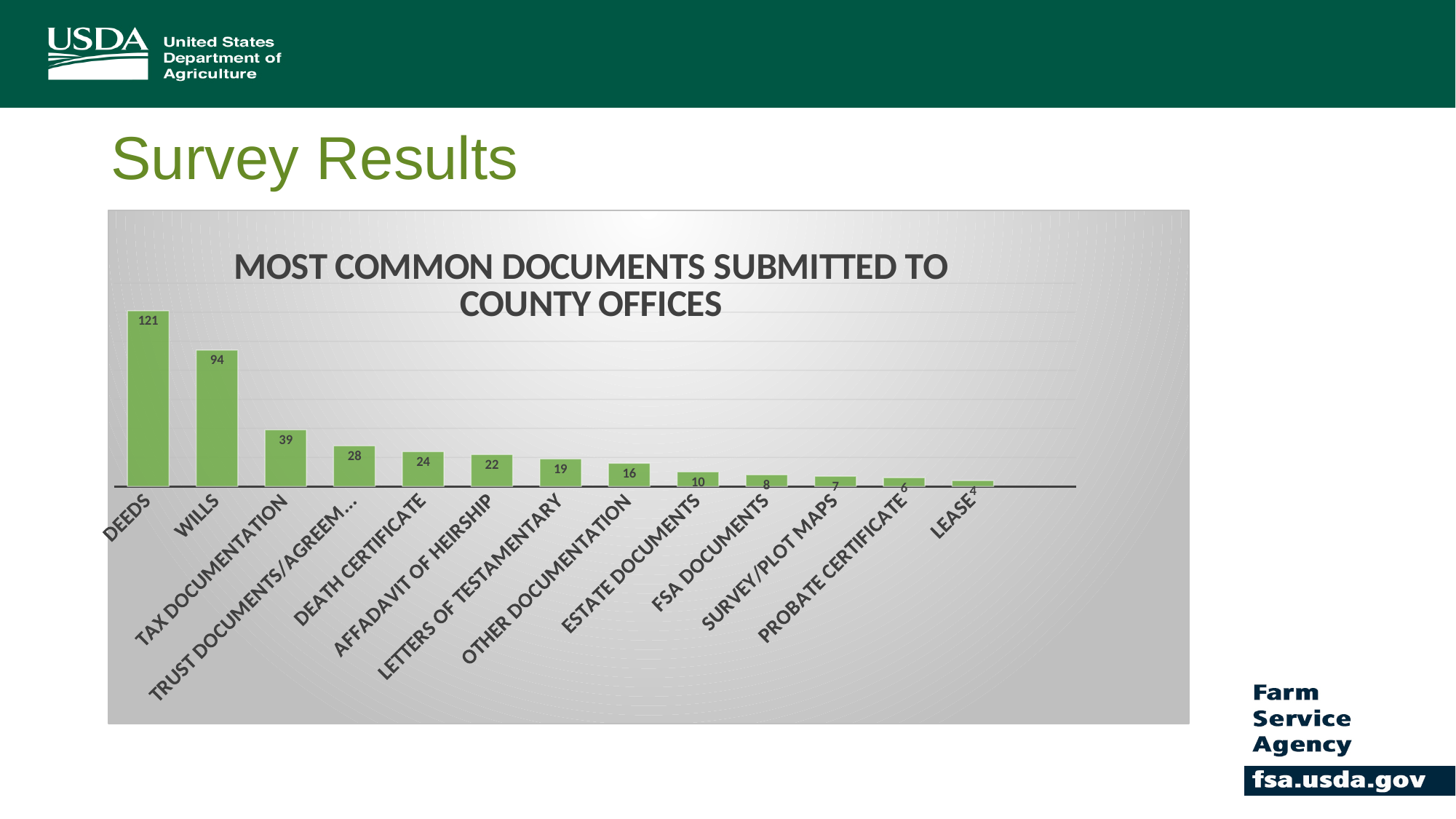
What is the value for DEATH CERTIFICATE? 24 What is the title of the chart? MOST COMMON DOCUMENTS SUBMITTED TO COUNTY OFFICES What is the value for WILLS? 94 Which category has the highest value? DEEDS What is the value for ESTATE DOCUMENTS? 10 What kind of chart is this? Bar chart What is the value for DEEDS? 121 How many categories are shown in the chart? 13 What is the difference between the values for DEEDS and WILLS? 27 Which is larger, the value for TAX DOCUMENTATION or the value for AFFADAVIT OF HEIRSHIP? TAX DOCUMENTATION Which category has the lowest value? LEASE Do the values rise or fall from left to right along the x axis? Fall